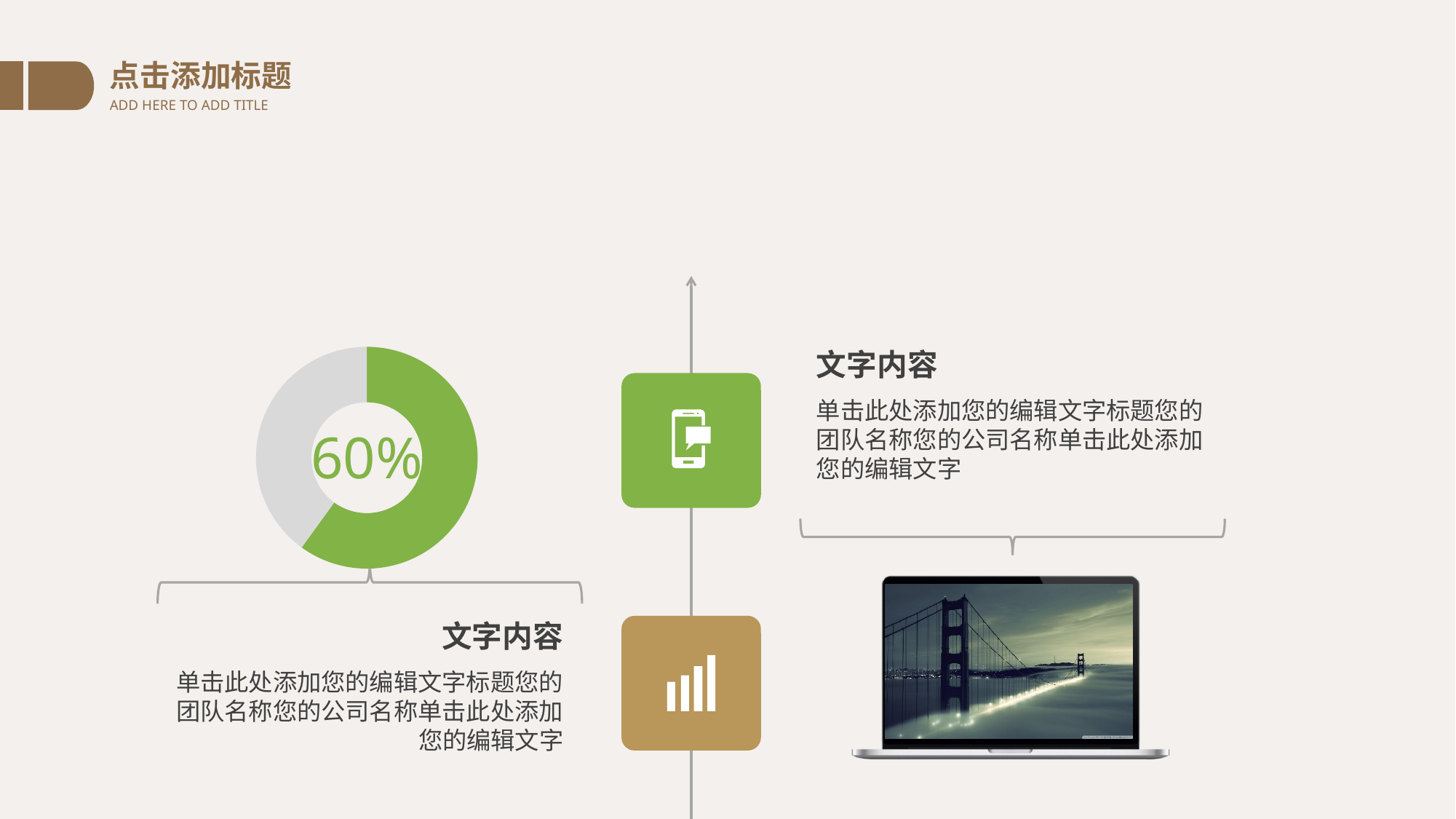
Is the green segment of the donut chart greater or less than 50%? greater What share of the donut chart does the grey segment represent? 40% How many segments does the donut chart have? 2 What percentage is printed in the centre of the donut chart? 60% What colour is the smaller segment of the donut chart? grey Which segment of the donut chart is larger, the green one or the grey one? green What kind of chart is shown on the slide? donut chart What colour is the segment of the donut chart that represents 60%? green What share of the donut chart does the green segment represent? 60%